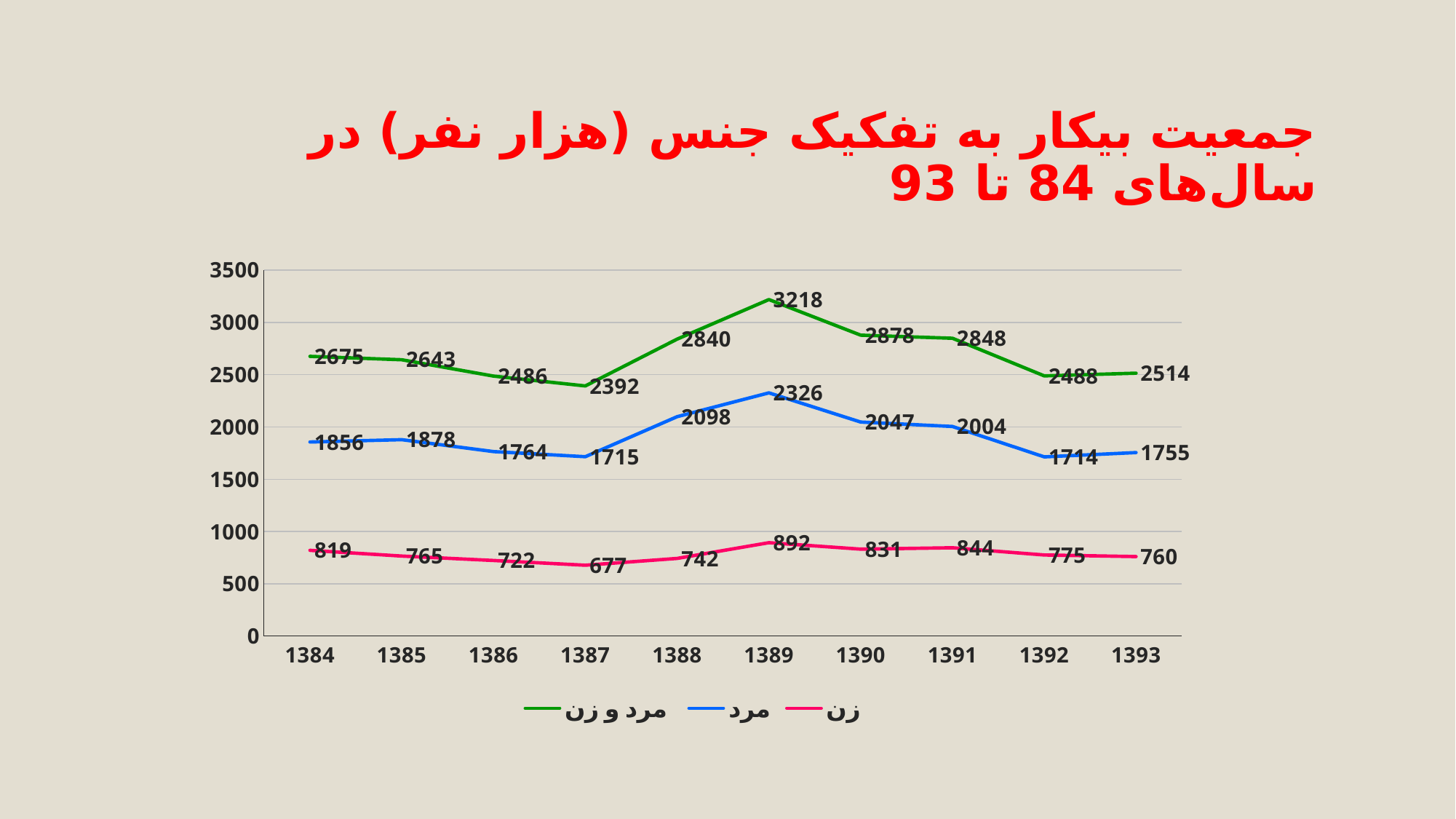
How many series does the legend list? 3 What is the value of the "زن" series in 1387? 677 What is the difference between the "مرد و زن" values in 1389 and 1388? 378 In which year does the "مرد و زن" series reach its highest value? 1389 How many years are plotted along the x axis? 10 What is the value of the "مرد و زن" series in 1393? 2514 Does the "مرد" series rise or fall from 1389 to 1392? fall What kind of chart is shown on the slide? line chart In which year does the "زن" series have its lowest value? 1387 Which colour is used for the "زن" series? pink What is the value of the "مرد" series in 1389? 2326 Which is larger: the "مرد" value in 1385 or in 1386? 1385